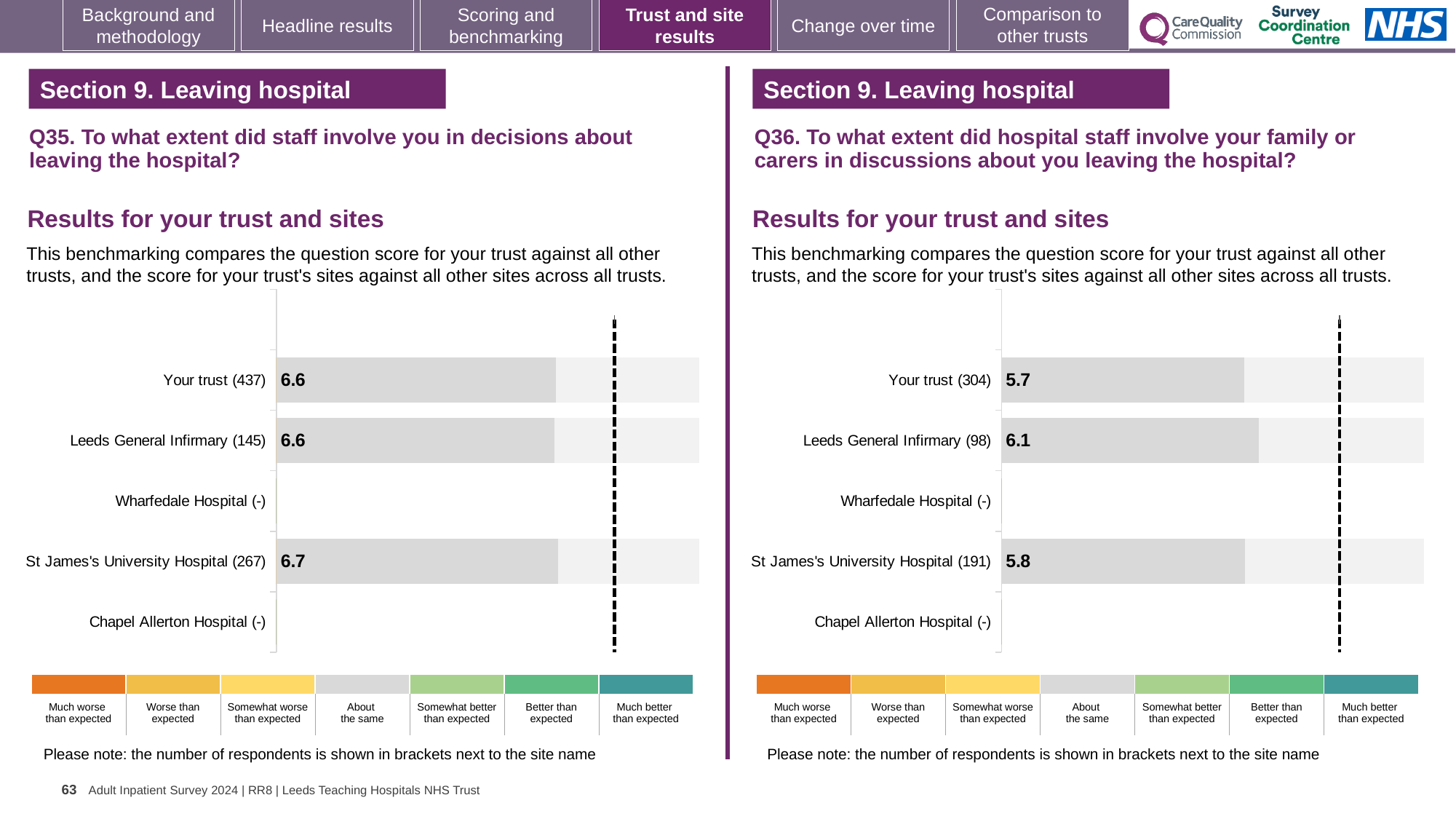
In the Q36 chart on the right, what is the score for Leeds General Infirmary? 6.1 In the Q36 chart on the right, how many respondents are shown in brackets for St James's University Hospital? 191 In the Q36 chart on the right, which is larger: the score for Leeds General Infirmary or the score for Your trust? Leeds General Infirmary In the Q35 chart on the left, how many respondents are shown in brackets for Leeds General Infirmary? 145 In the Q35 chart on the left, what is the score for St James's University Hospital? 6.7 In the Q35 chart on the left, how many rows (trust and sites) are listed on the vertical axis? 5 In the Q36 chart on the right, which site has the highest score? Leeds General Infirmary What kind of chart is used in the Q35 chart on the left? Bar chart In the Q35 chart on the left, what is the score for Your trust? 6.6 In the Q36 chart on the right, what is the score for Your trust? 5.7 In the Q36 chart on the right, what is the difference between the scores for Leeds General Infirmary and St James's University Hospital? 0.3 In the Q35 chart on the left, what is the difference between the scores for St James's University Hospital and Your trust? 0.1